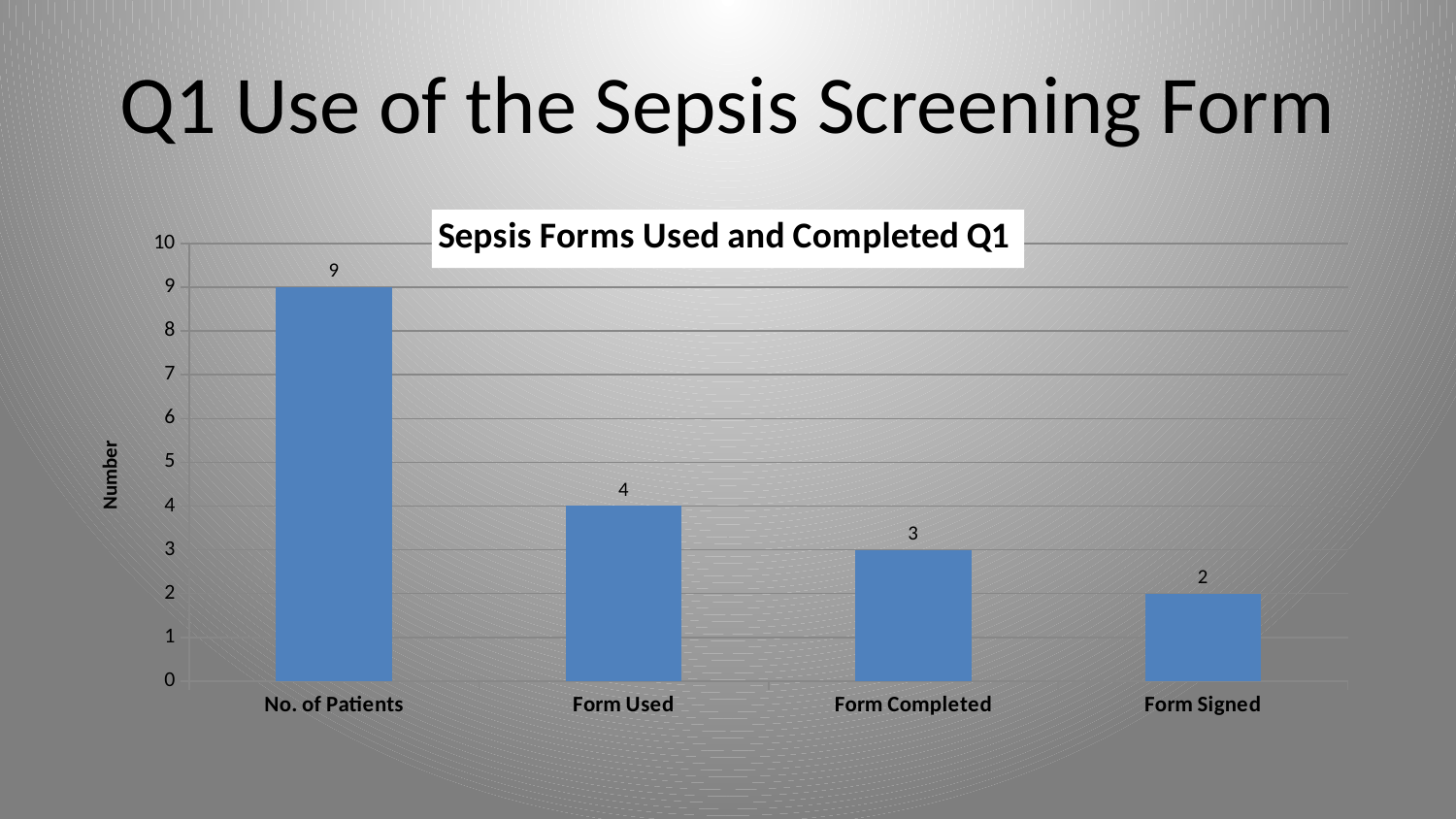
Which category has the highest value? No. of Patients How many categories are shown on the x axis? 4 What is the value for Form Completed? 3 What is the value for No. of Patients? 9 What is the value for Form Signed? 2 What is the difference between No. of Patients and Form Used? 5 What is the difference between Form Used and Form Signed? 2 Which is larger, Form Completed or Form Signed? Form Completed Which category has the lowest value? Form Signed What is the value for Form Used? 4 What kind of chart is shown? Bar chart What is the title of the chart? Sepsis Forms Used and Completed Q1